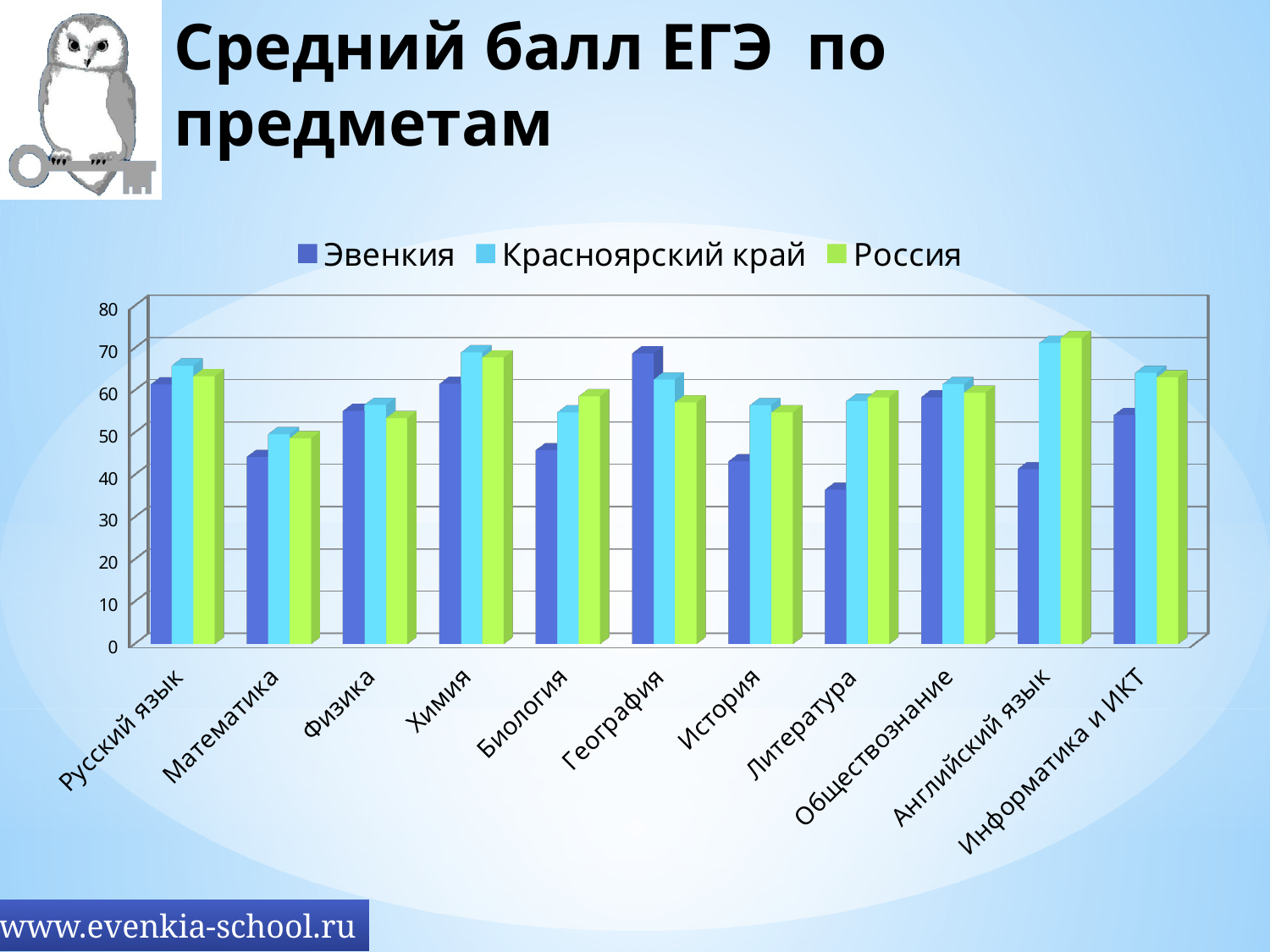
Is the Красноярский край value for Английский язык greater or less than 60? greater How many subjects (categories) are shown on the x axis? 11 How many series does the legend list? 3 What kind of chart is shown on the slide? bar chart For Английский язык, which is larger: the value for Эвенкия or the value for Россия? Россия For which subject is the Эвенкия value the lowest? Литература For География, which is larger: the value for Эвенкия or the value for Россия? Эвенкия Is the Эвенкия value for Литература greater or less than 40? less Is the Эвенкия value for Математика greater or less than 50? less For which subject is the Эвенкия value the highest? География Which series is shown in green in the legend? Россия What is the title of the slide's chart? Средний балл ЕГЭ по предметам